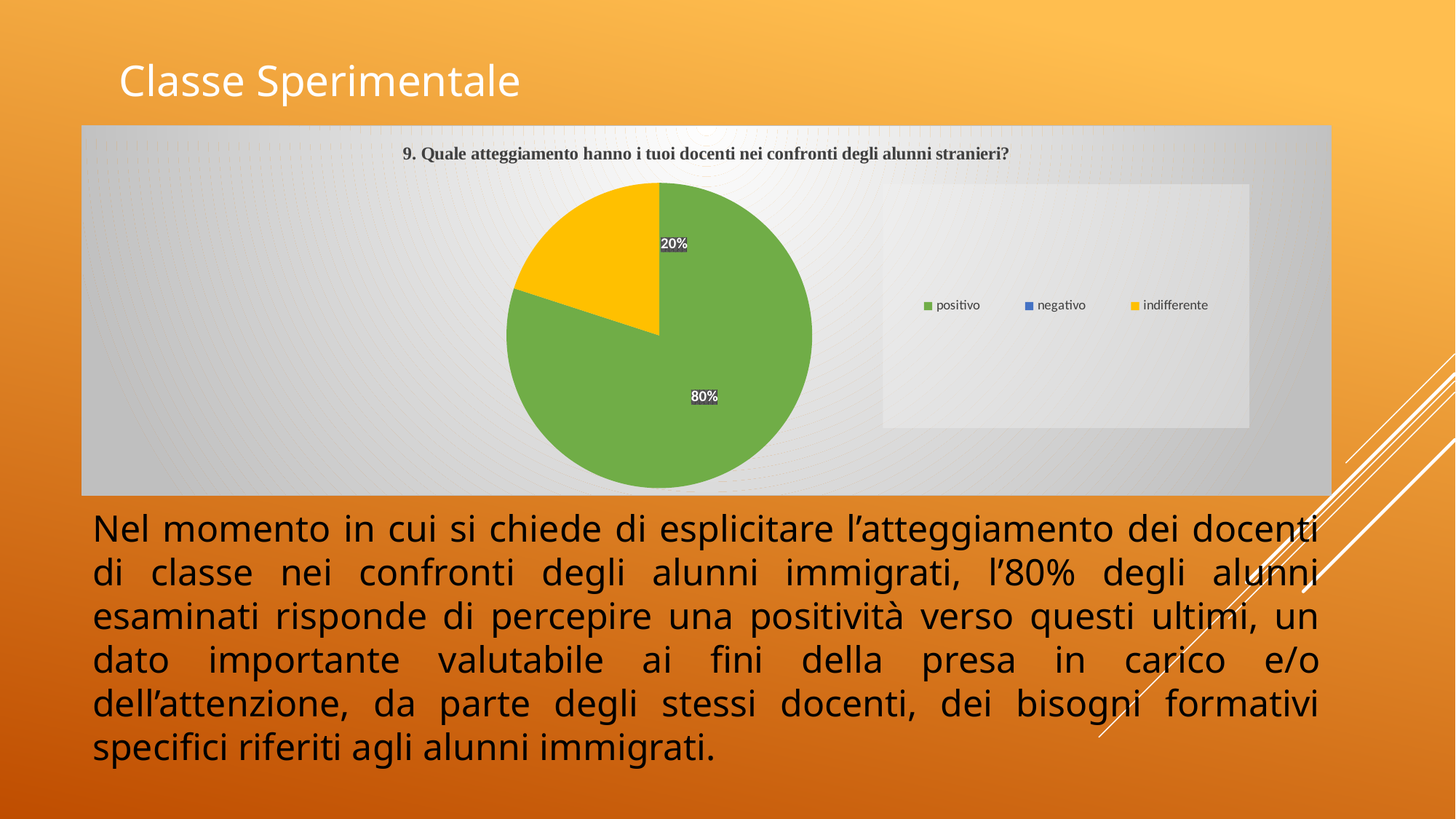
Which is larger, the slice for "positivo" or the slice for "indifferente"? positivo What share of the pie does "indifferente" represent? 20% What is the title of the chart? 9. Quale atteggiamento hanno i tuoi docenti nei confronti degli alunni stranieri? Which colour represents "indifferente" in the chart? yellow How many entries does the legend list? 3 What share of the pie does "positivo" represent? 80% What is the difference in percentage points between the "positivo" and "indifferente" slices? 60 Which category has the largest slice of the pie? positivo What kind of chart is shown on the slide? pie chart Is the share for "positivo" greater or less than 50%? greater